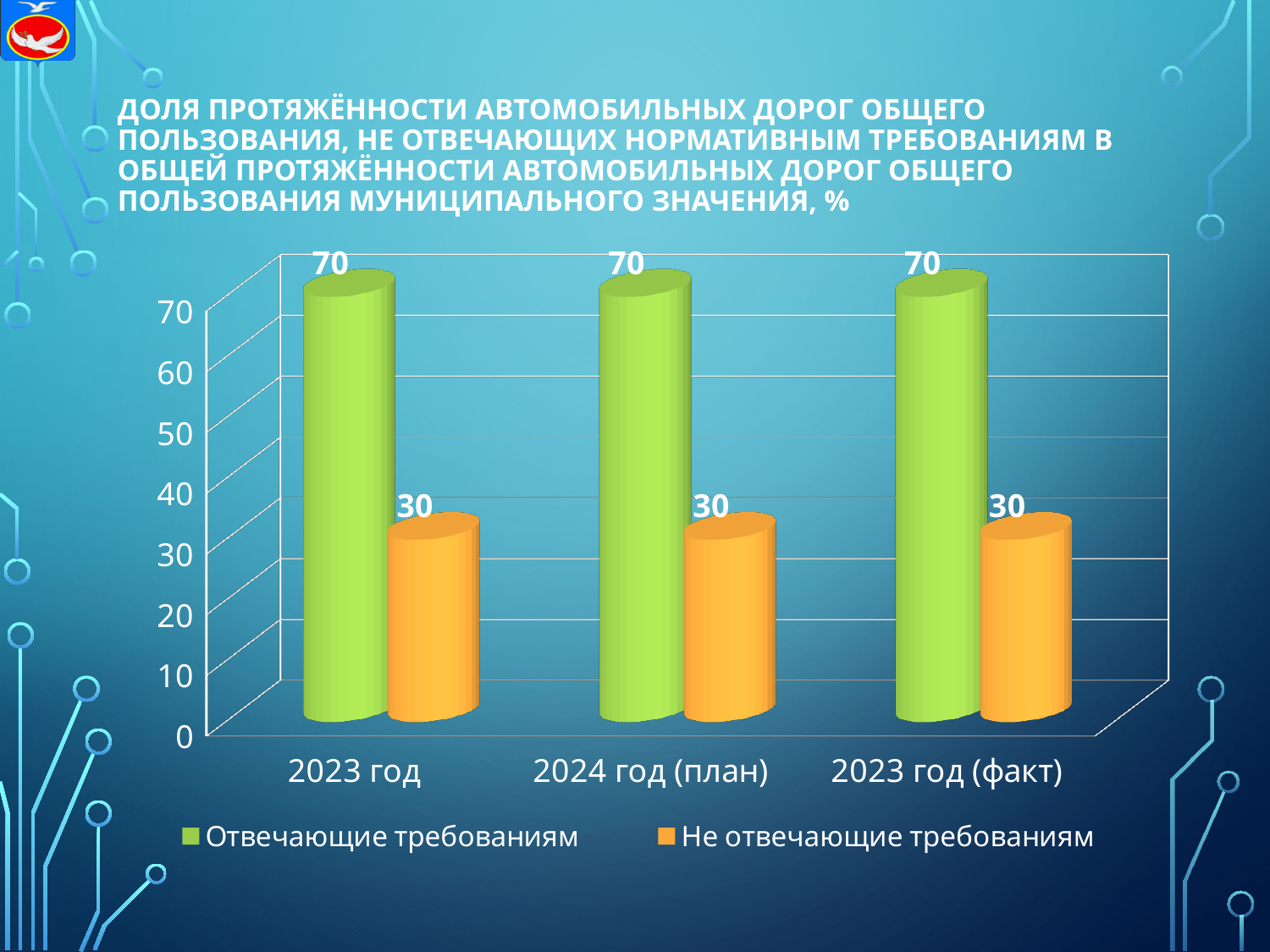
What is the value for "Отвечающие требованиям" in 2023 год? 70 Do the values for "Отвечающие требованиям" rise, fall or stay the same across the categories? stay the same What is the value for "Не отвечающие требованиям" in 2024 год (план)? 30 How many series does the legend list? 2 What is the difference between "Отвечающие требованиям" and "Не отвечающие требованиям" in 2024 год (план)? 40 What is the value for "Отвечающие требованиям" in 2023 год (факт)? 70 What kind of chart is shown on the slide? bar chart What colour represents "Не отвечающие требованиям" in the legend? orange What is the value for "Не отвечающие требованиям" in 2023 год? 30 How many categories are shown on the x axis? 3 Which series has the larger value in 2023 год (факт): "Отвечающие требованиям" or "Не отвечающие требованиям"? Отвечающие требованиям What is the total of "Отвечающие требованиям" and "Не отвечающие требованиям" for 2023 год? 100